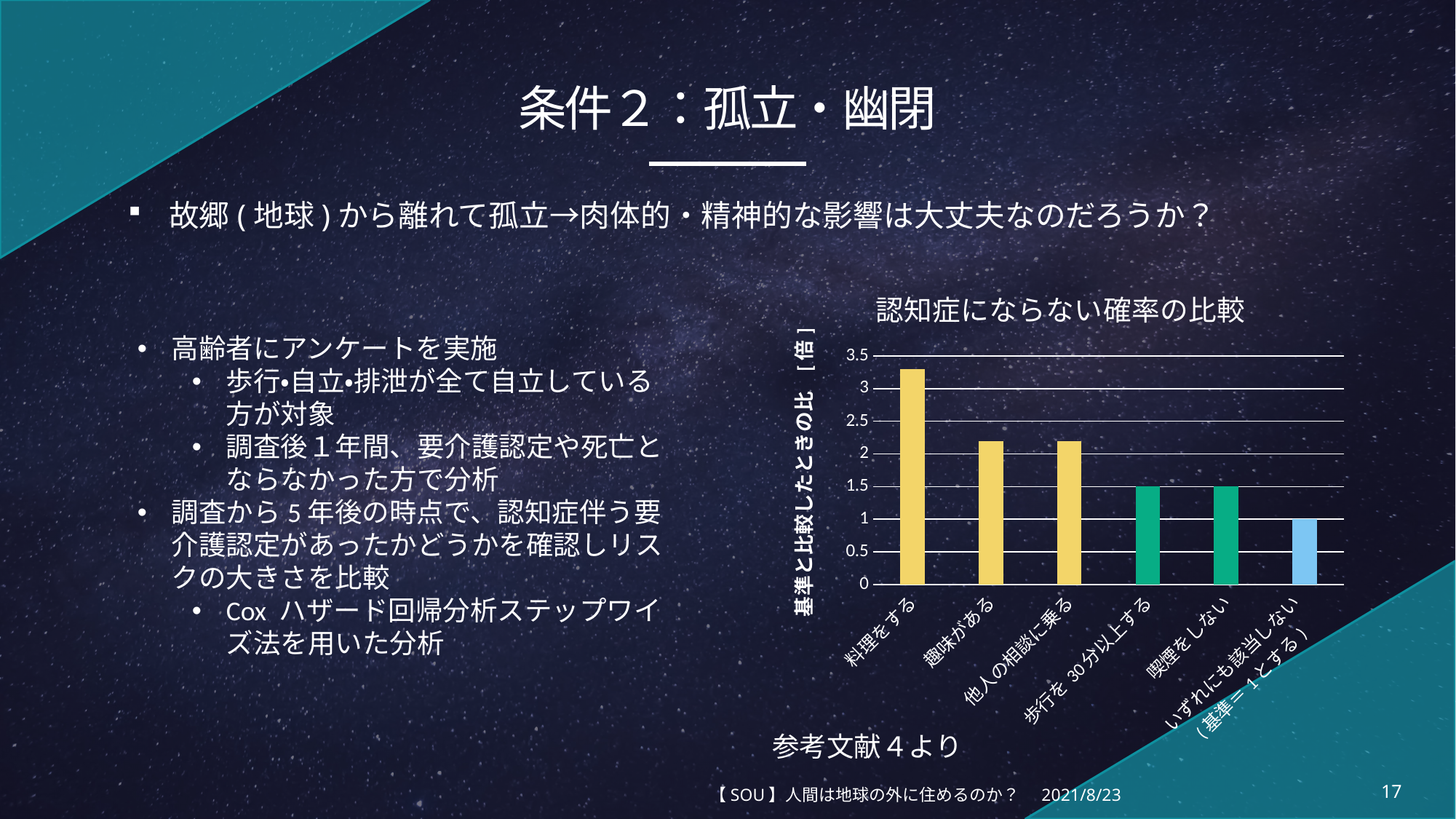
What is the value for いずれにも該当しない（基準＝1とする）? 1 What is the value for 喫煙をしない? 1.5 Is the value for 趣味がある greater or less than 2? greater Which category has the lowest value in the chart? いずれにも該当しない（基準＝1とする） What is the value for 歩行を30分以上する? 1.5 What is the title of the chart? 認知症にならない確率の比較 Which category has the highest value in the chart? 料理をする Is the value for 料理をする greater or less than 3? greater Which is larger, the value for 料理をする or the value for 趣味がある? 料理をする What type of chart is shown on the slide? bar chart How many categories are plotted in the chart? 6 What is the difference between the value for 歩行を30分以上する and the value for いずれにも該当しない（基準＝1とする）? 0.5